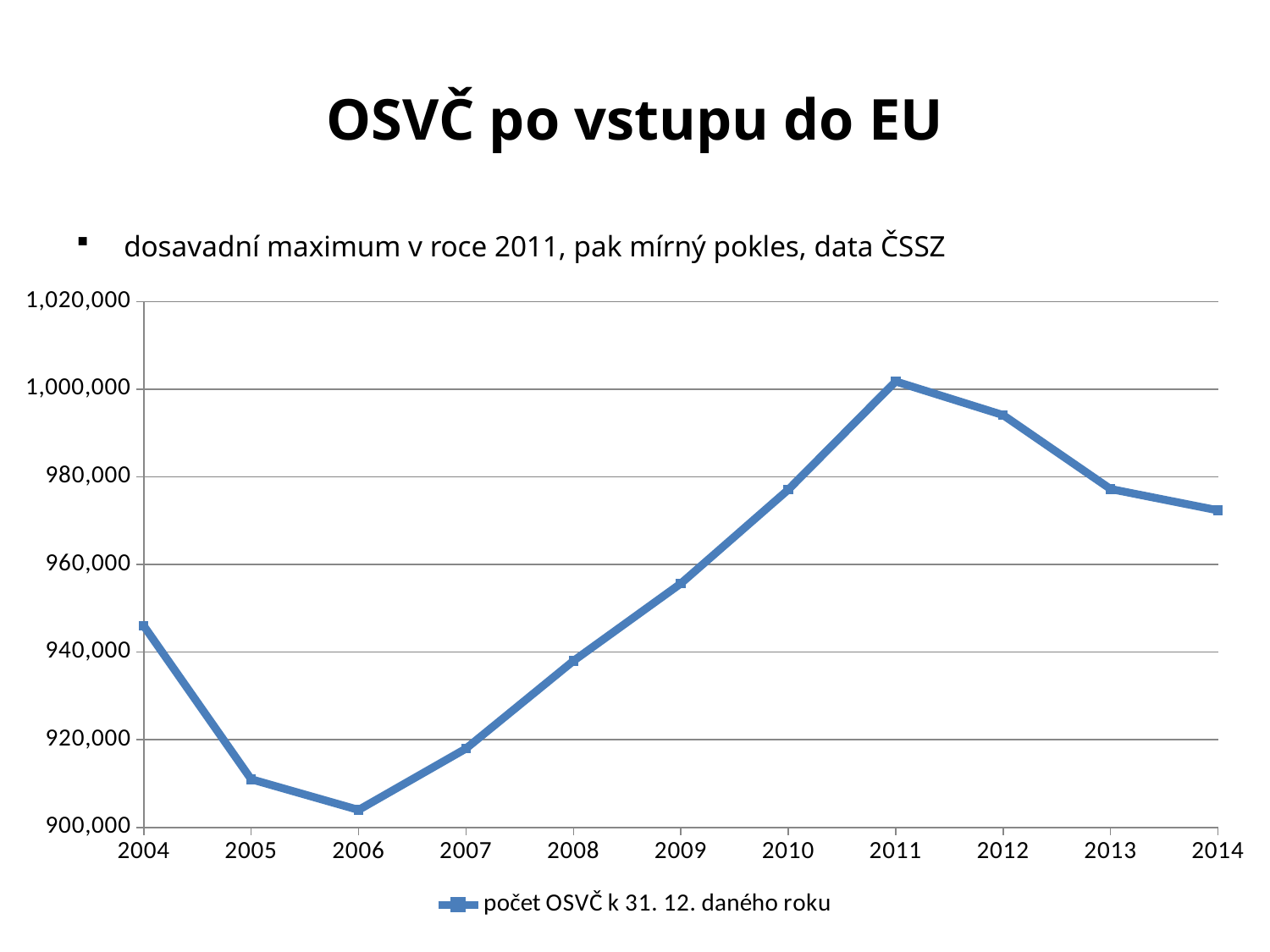
Which year has the larger value, 2009 or 2014? 2014 How many years are plotted on the x axis of the chart? 11 What is the legend entry for the plotted series? počet OSVČ k 31. 12. daného roku Is the value for 2009 greater or less than 960,000? less Is the value for 2004 greater or less than 940,000? greater Is the value for 2012 greater or less than 1,000,000? less How many series does the chart's legend list? 1 In which year does the number of OSVČ reach its lowest value? 2006 Do the values rise or fall from 2006 to 2011? rise Which year has the larger value, 2004 or 2005? 2004 In which year does the number of OSVČ reach its highest value? 2011 What kind of chart is shown on the slide? line chart